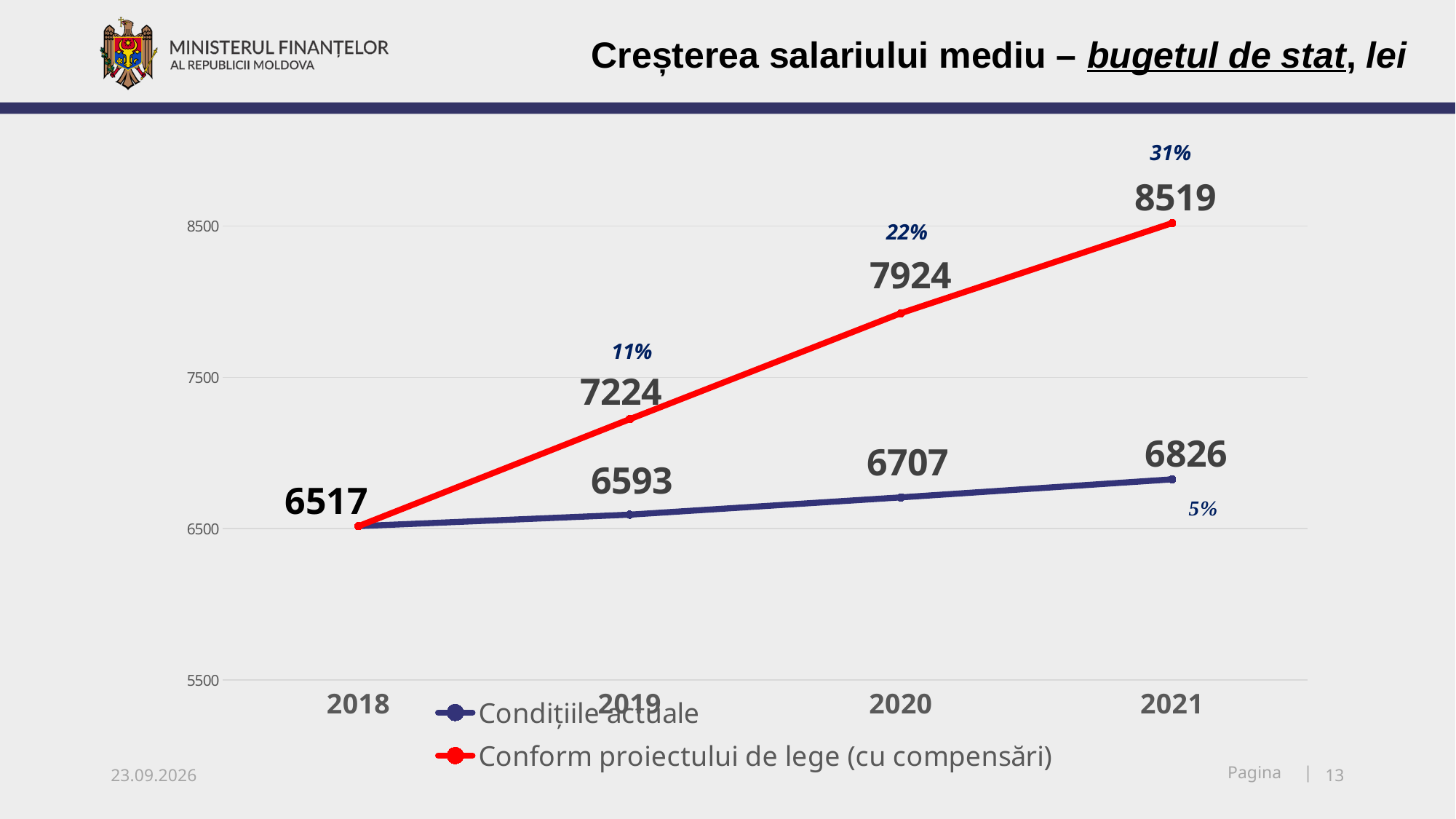
What is the difference between the two series in 2021? 1693 How many years are shown on the x axis? 4 Which series has the larger value in 2020? Conform proiectului de lege (cu compensări) What is the difference between the 2020 and 2019 values in the 'Conform proiectului de lege (cu compensări)' series? 700 What is the value for 2020 in the 'Condițiile actuale' series? 6707 What kind of chart is shown on the slide? Line chart What is the value for 2019 in the 'Conform proiectului de lege (cu compensări)' series? 7224 How many series does the legend list? 2 What is the value for 2021 in the 'Conform proiectului de lege (cu compensări)' series? 8519 Do the values in the 'Conform proiectului de lege (cu compensări)' series rise or fall from 2018 to 2021? Rise Which year has the highest value in the 'Condițiile actuale' series? 2021 What is the value shown for 2018? 6517